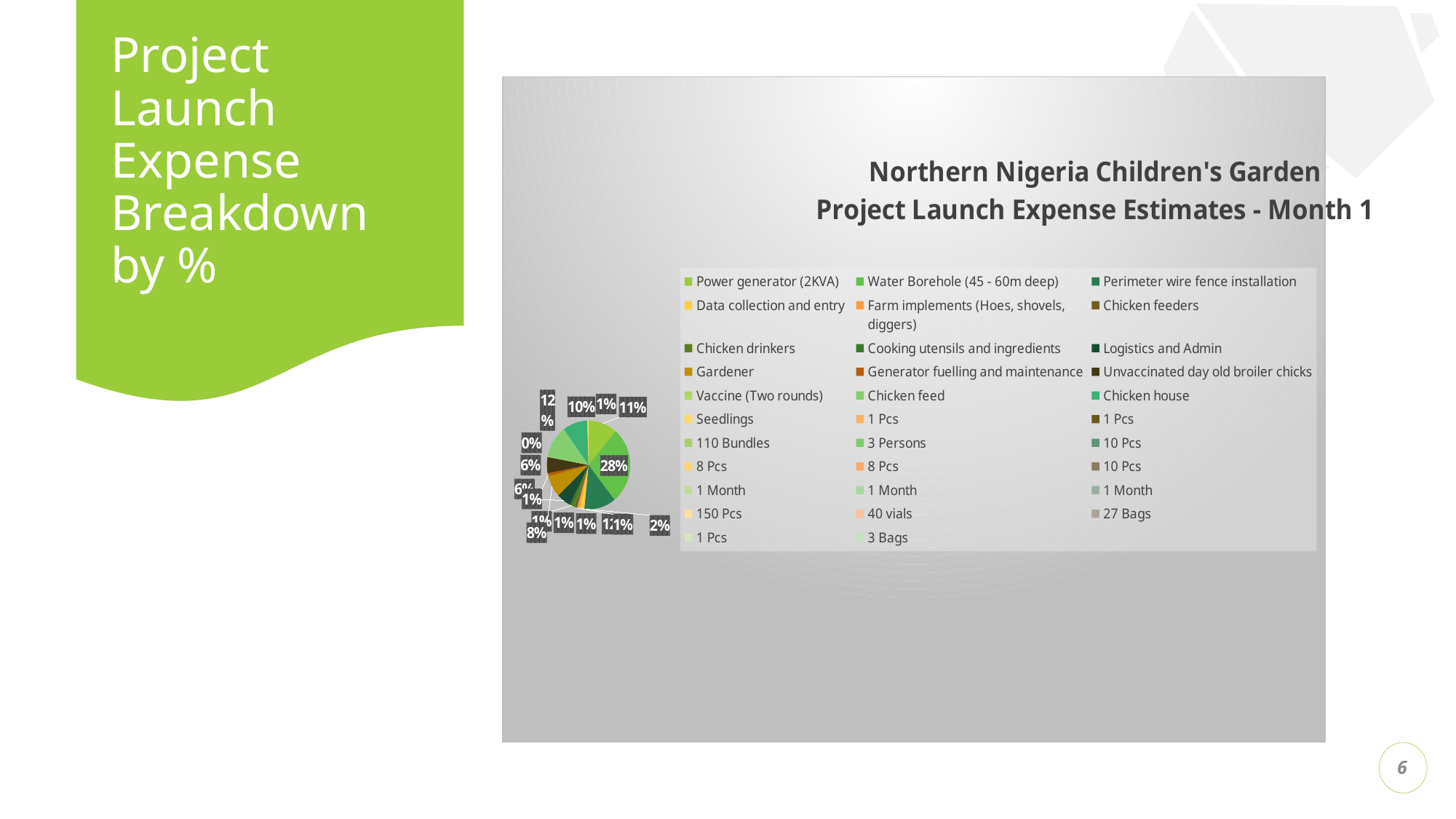
What is the combined share of the 12% and 11% slices? 23% What is the smallest percentage label shown on the pie chart? 0% What is the title of the chart? Northern Nigeria Children's Garden Project Launch Expense Estimates - Month 1 Is the largest slice of the pie greater or less than 25%? greater Which is larger, the 12% slice or the 10% slice? the 12% slice What is the difference between the 12% slice and the 10% slice? 2 percentage points What share of the pie does the largest slice represent? 28% What is the largest percentage shown on any slice of the pie chart? 28% What is the first entry listed in the chart's legend? Power generator (2KVA) How many entries does the chart's legend list? 32 What kind of chart is shown on the slide? pie chart What is the difference between the largest slice (28%) and the 11% slice? 17 percentage points